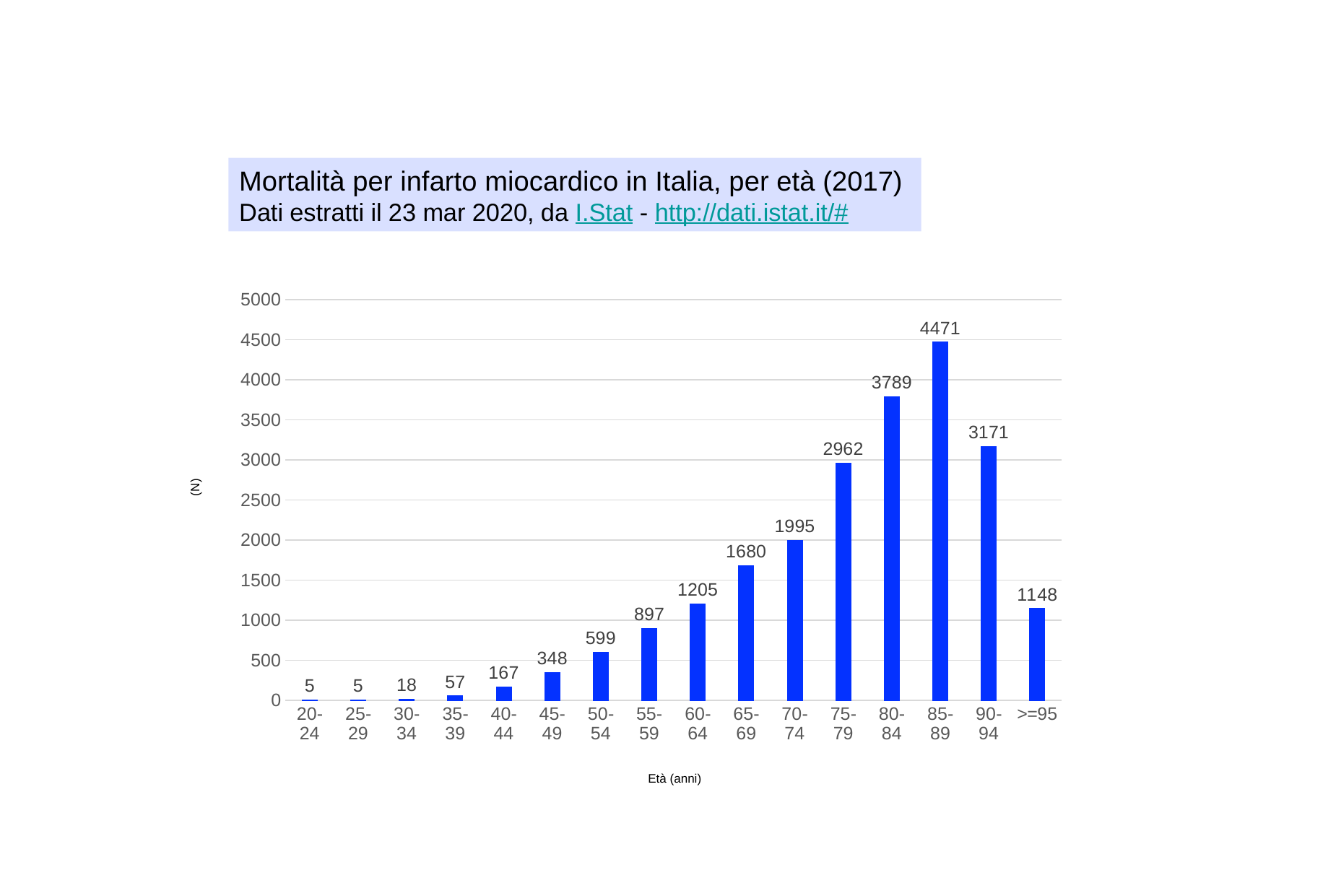
What kind of chart is shown on the slide? Bar chart Do the values rise or fall from the 20-24 group to the 85-89 group? Rise Which is larger, the value for 90-94 or the value for 75-79? 90-94 What is the label of the x axis? Età (anni) What is the difference between the values for 85-89 and 80-84? 682 What is the value for the 85-89 age group? 4471 Is the value for 70-74 greater or less than 1500? greater How many age groups are shown on the x axis? 16 What is the value for the >=95 age group? 1148 Which age group has the highest value? 85-89 What is the value for the 60-64 age group? 1205 Which age group has the lowest value? 20-24 and 25-29 (both 5)